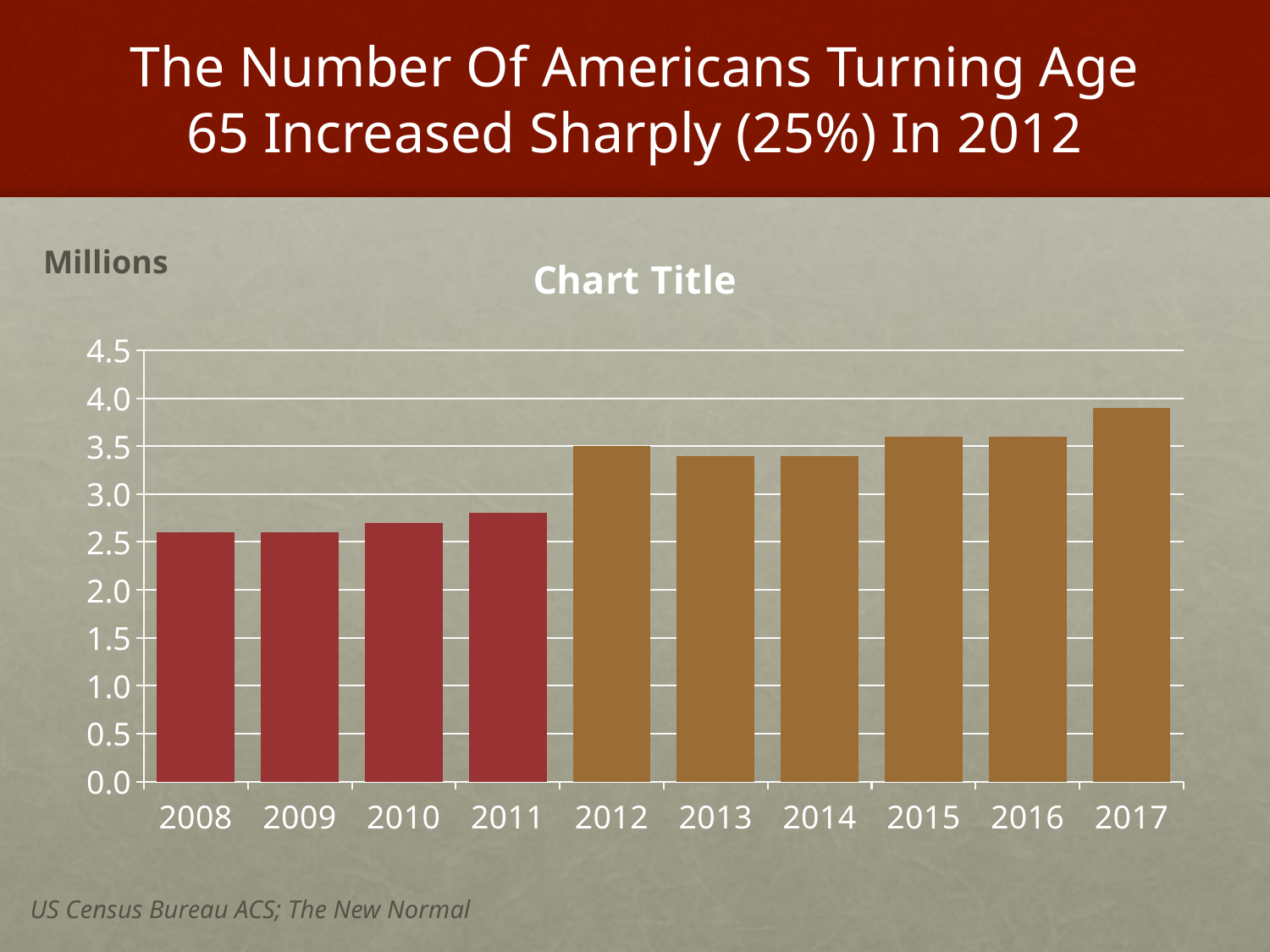
What unit label is shown above the vertical axis of the chart? Millions Which is larger, the value for 2012 or the value for 2011? 2012 Is the value for 2008 greater or less than 2.5? greater Which is larger, the value for 2017 or the value for 2015? 2017 How many years are shown on the x axis of the chart? 10 What kind of chart is shown on the slide? bar chart Is the value for 2017 greater or less than 4.0? less Which year has the highest bar in the chart? 2017 Do the values generally rise or fall from 2008 to 2017? rise What is the title printed above the chart's plot area? Chart Title Is the value for 2012 greater or less than 3.0? greater